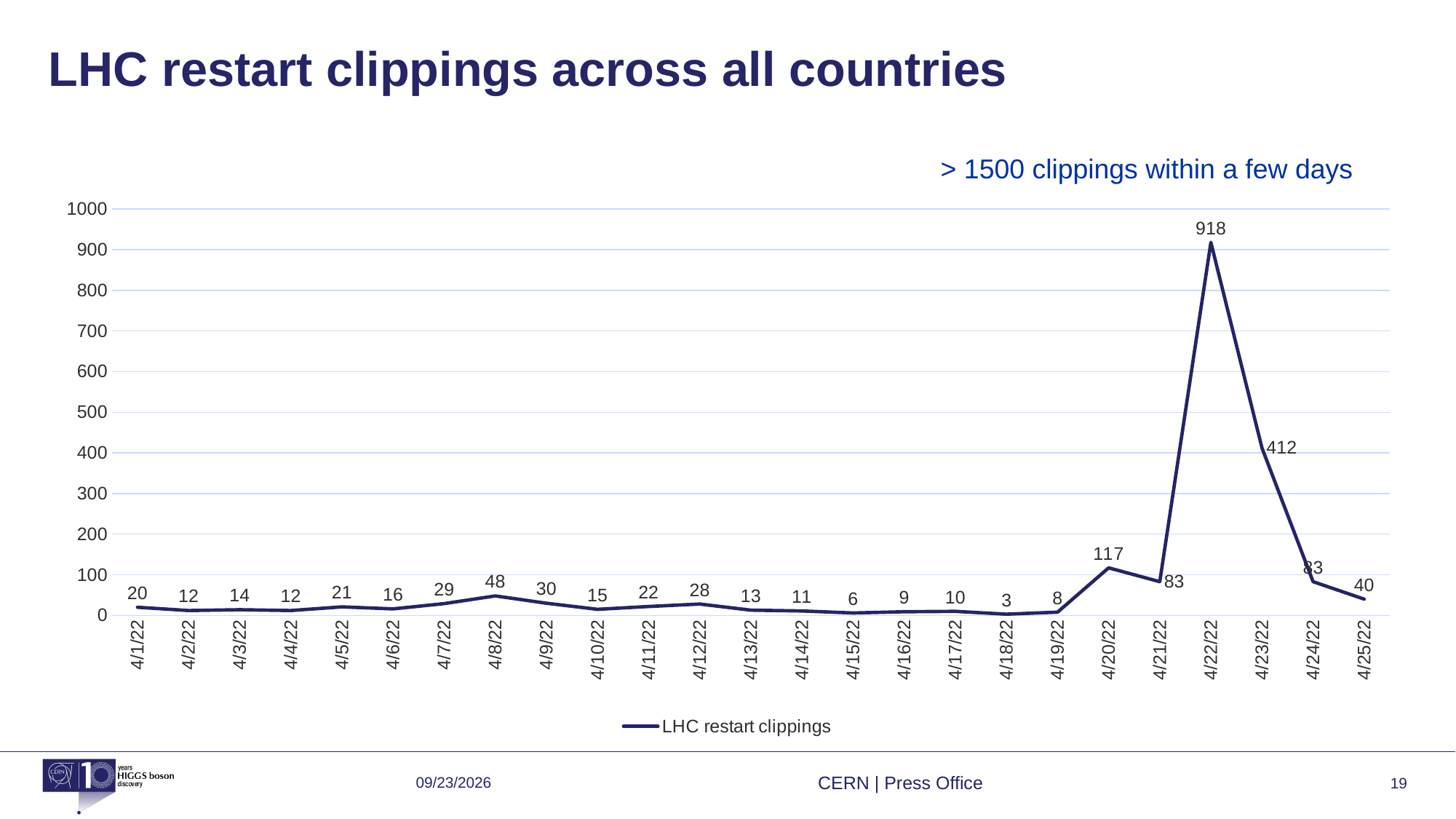
What is the value for 4/22/22? 918 Which date has the lowest value? 4/18/22 How many series does the legend list? 1 Which date has the highest value? 4/22/22 How many dates are plotted on the x axis? 25 What is the value for 4/8/22? 48 What is the value for 4/23/22? 412 What is the legend entry for the plotted series? LHC restart clippings What kind of chart is shown? line chart What is the difference between the values for 4/22/22 and 4/23/22? 506 What is the value for 4/20/22? 117 Which is larger, the value for 4/20/22 or the value for 4/21/22? 4/20/22